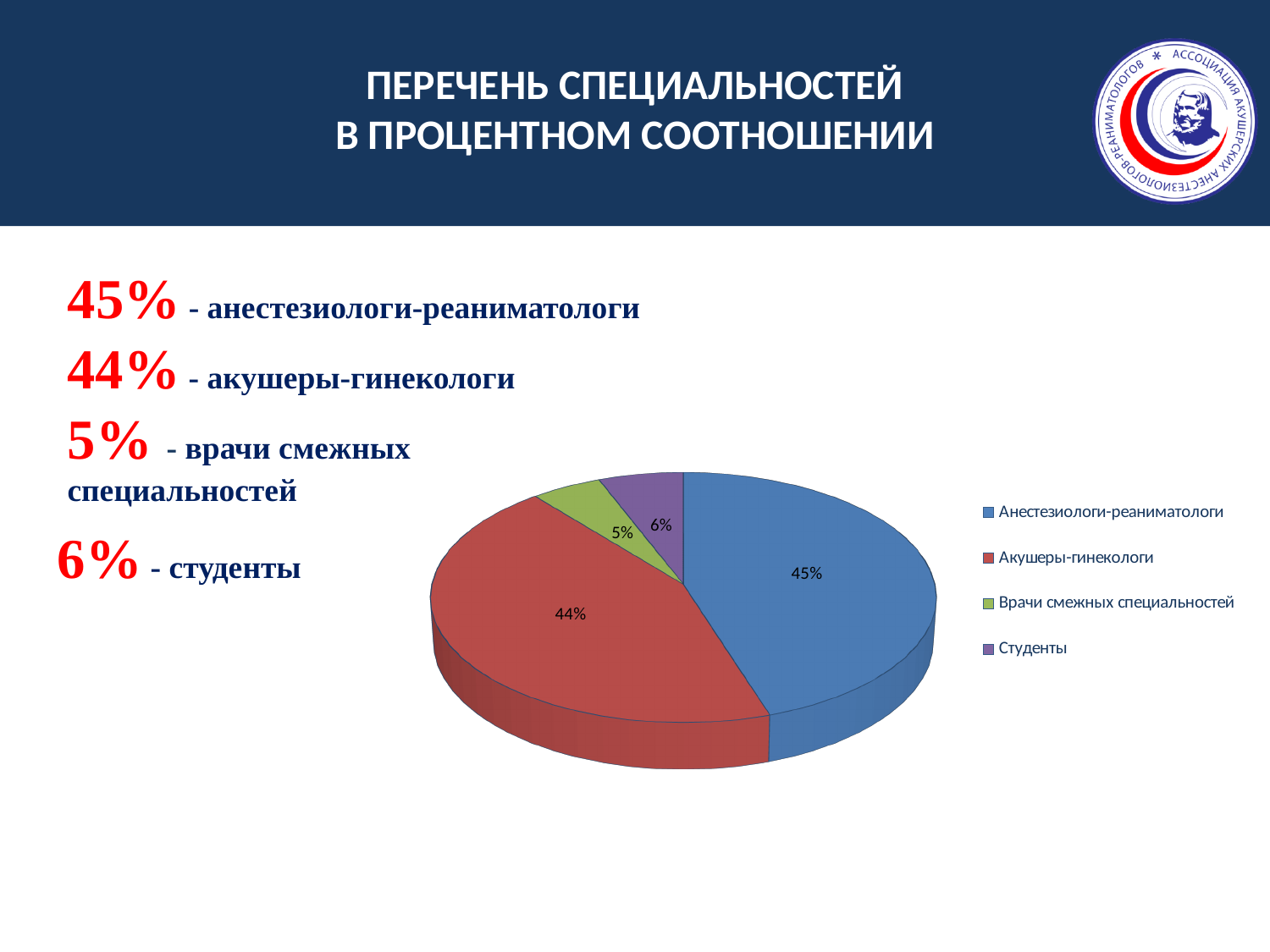
What kind of chart is shown on the slide? pie chart What share of the pie is labelled for Акушеры-гинекологи? 44% What is the difference in percentage points between the Акушеры-гинекологи slice and the Врачи смежных специальностей slice? 39% What share of the pie is labelled for Анестезиологи-реаниматологи? 45% Which category has the smallest slice of the pie? Врачи смежных специальностей What colour is the Акушеры-гинекологи slice? red Which slice is larger: Студенты or Врачи смежных специальностей? Студенты What share of the pie is labelled for Студенты? 6% Which category has the largest slice of the pie? Анестезиологи-реаниматологи How many categories does the legend list? 4 What is the difference in percentage points between the Анестезиологи-реаниматологи slice and the Студенты slice? 39%